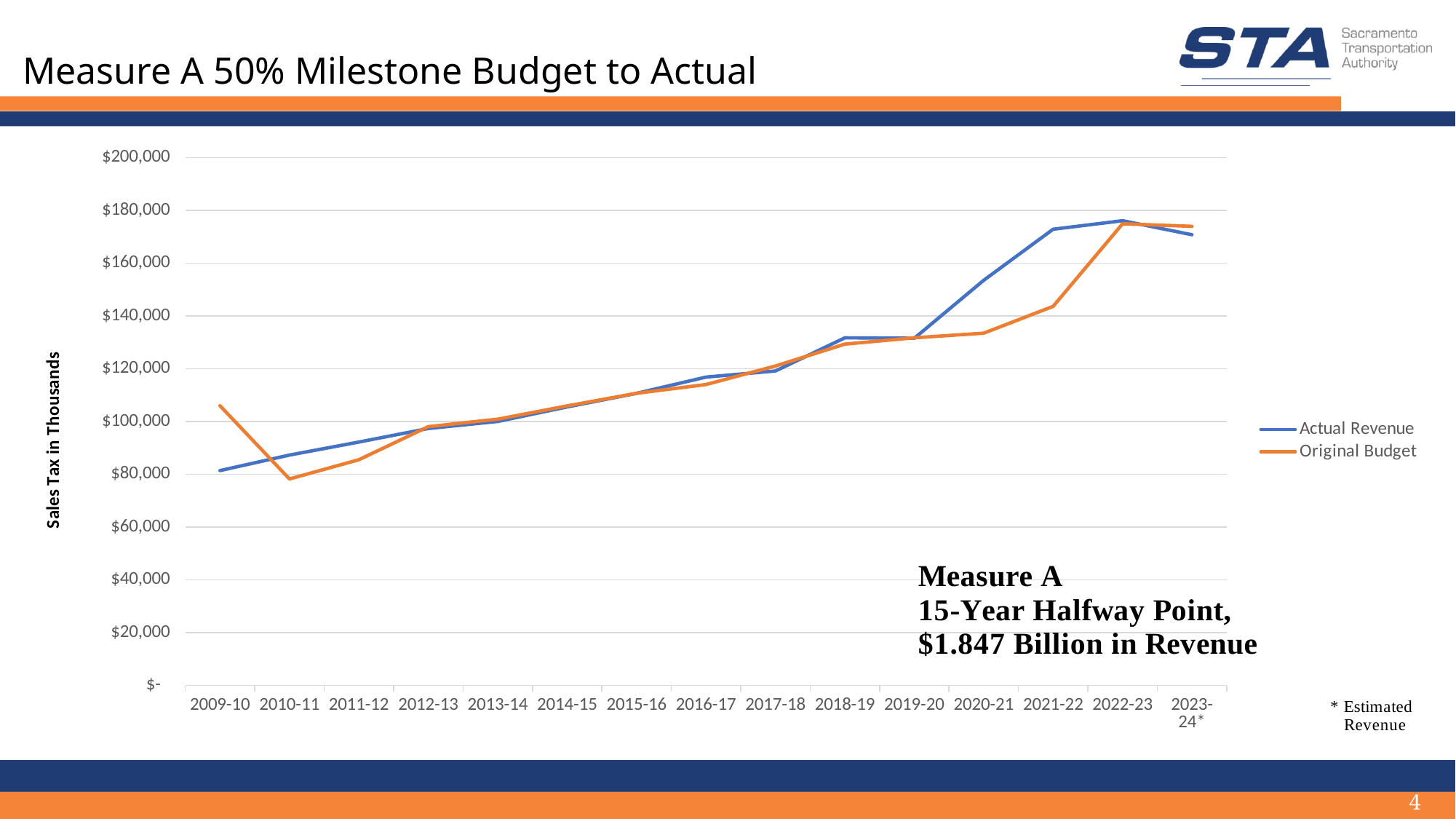
What kind of chart is shown on the slide? Line chart In 2021-22, which is larger: Actual Revenue or Original Budget? Actual Revenue Is the Original Budget value for 2009-10 greater or less than $100,000? greater Which series does the orange line represent? Original Budget How many series does the legend list? 2 Is the Actual Revenue value for 2009-10 greater or less than $100,000? less Is the Original Budget value for 2021-22 greater or less than $160,000? less What is the label on the vertical axis? Sales Tax in Thousands In 2009-10, which is larger: Actual Revenue or Original Budget? Original Budget In which fiscal year is the Original Budget at its lowest? 2010-11 How many fiscal years are plotted along the x axis? 15